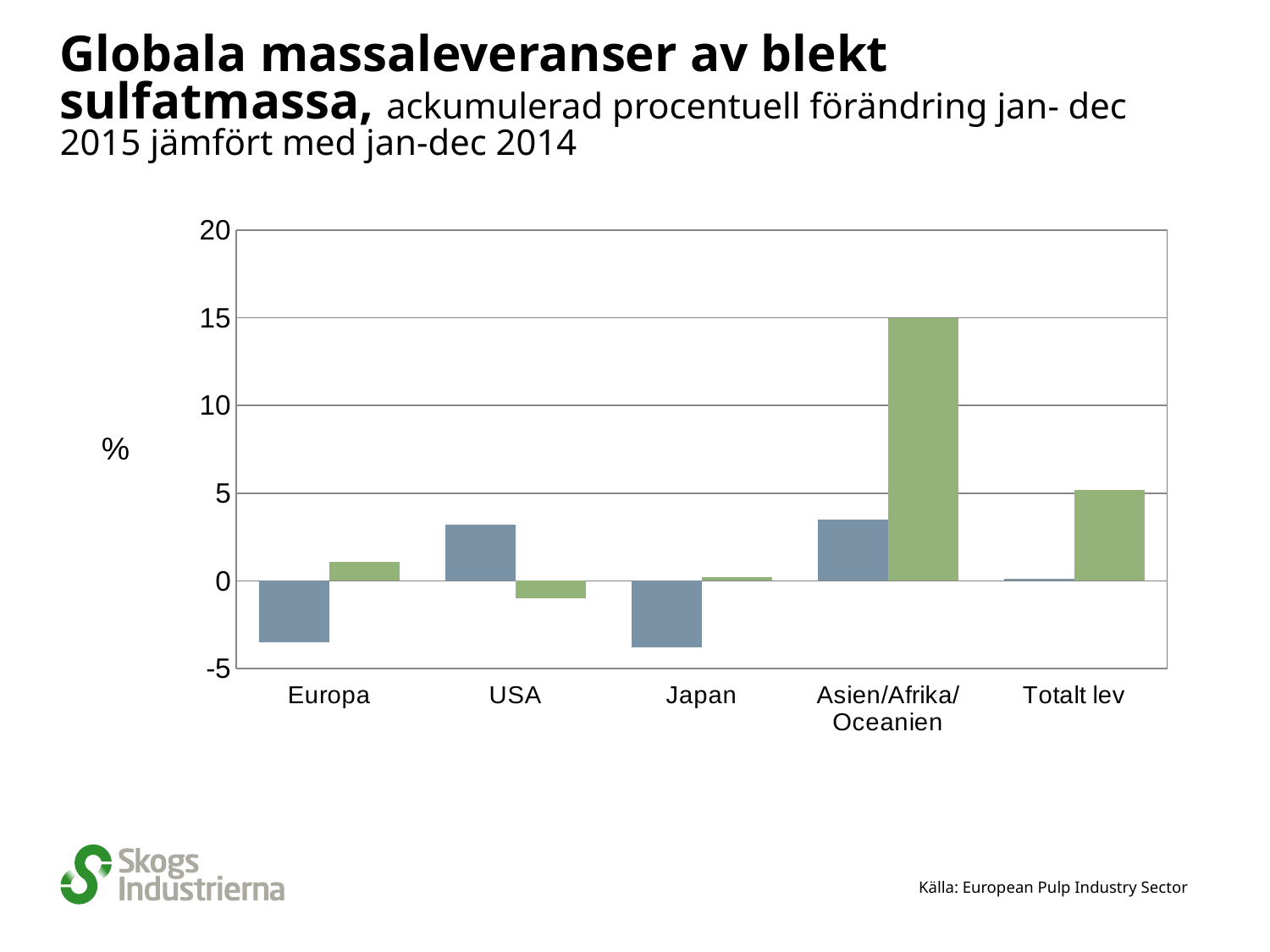
What kind of chart is shown on the slide? bar chart Which is larger: the blue bar for USA or the blue bar for Japan? USA Is the blue bar for USA greater or less than 0? greater Is the green bar for Asien/Afrika/Oceanien greater or less than 10? greater What unit is shown on the y axis of the chart? % How many categories have a blue bar below 0? 2 Is the green bar for Totalt lev greater or less than 10? less Which category has the tallest bar in the chart? Asien/Afrika/Oceanien How many categories are shown on the x axis of the chart? 5 Which is larger: the green bar for Totalt lev or the green bar for Europa? Totalt lev What source is cited for the chart? European Pulp Industry Sector